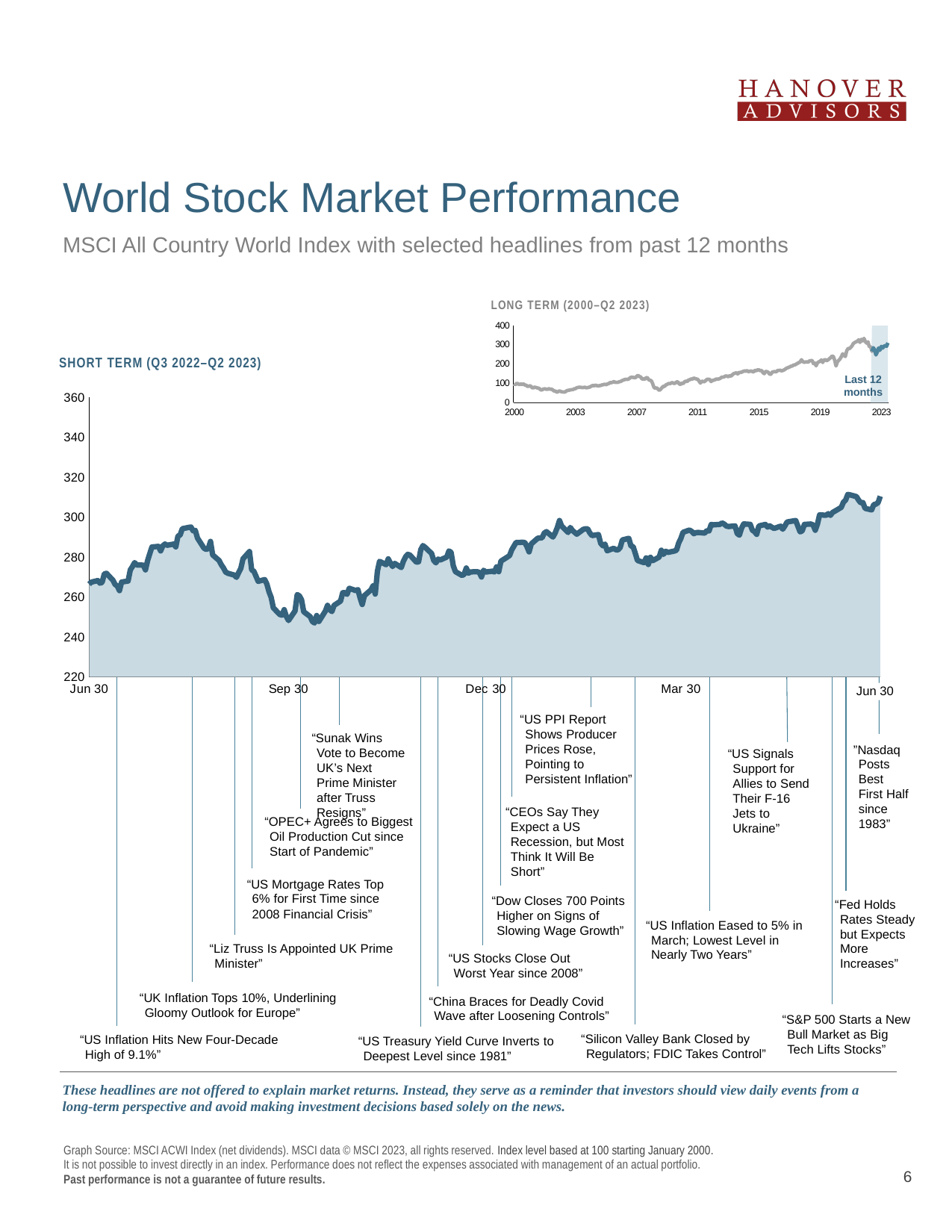
On the SHORT TERM chart, does the index end higher or lower at the final Jun 30 than it started at the first Jun 30? higher On the LONG TERM chart, is the index value in 2023 greater or less than 200? greater On the SHORT TERM chart, is the lowest point of the line greater or less than 260? less On the SHORT TERM chart, is the index value at the ending Jun 30 greater or less than 300? greater How many date labels are shown on the x axis of the SHORT TERM chart? 5 What kind of chart is the LONG TERM (2000–Q2 2023) chart? line chart On the LONG TERM chart, does the index generally rise or fall from 2000 to 2023? rise What kind of chart is the SHORT TERM (Q3 2022–Q2 2023) chart? line chart On the LONG TERM chart, what is the index level at the start in 2000? 100 What label is given to the shaded region at the right of the LONG TERM chart? Last 12 months